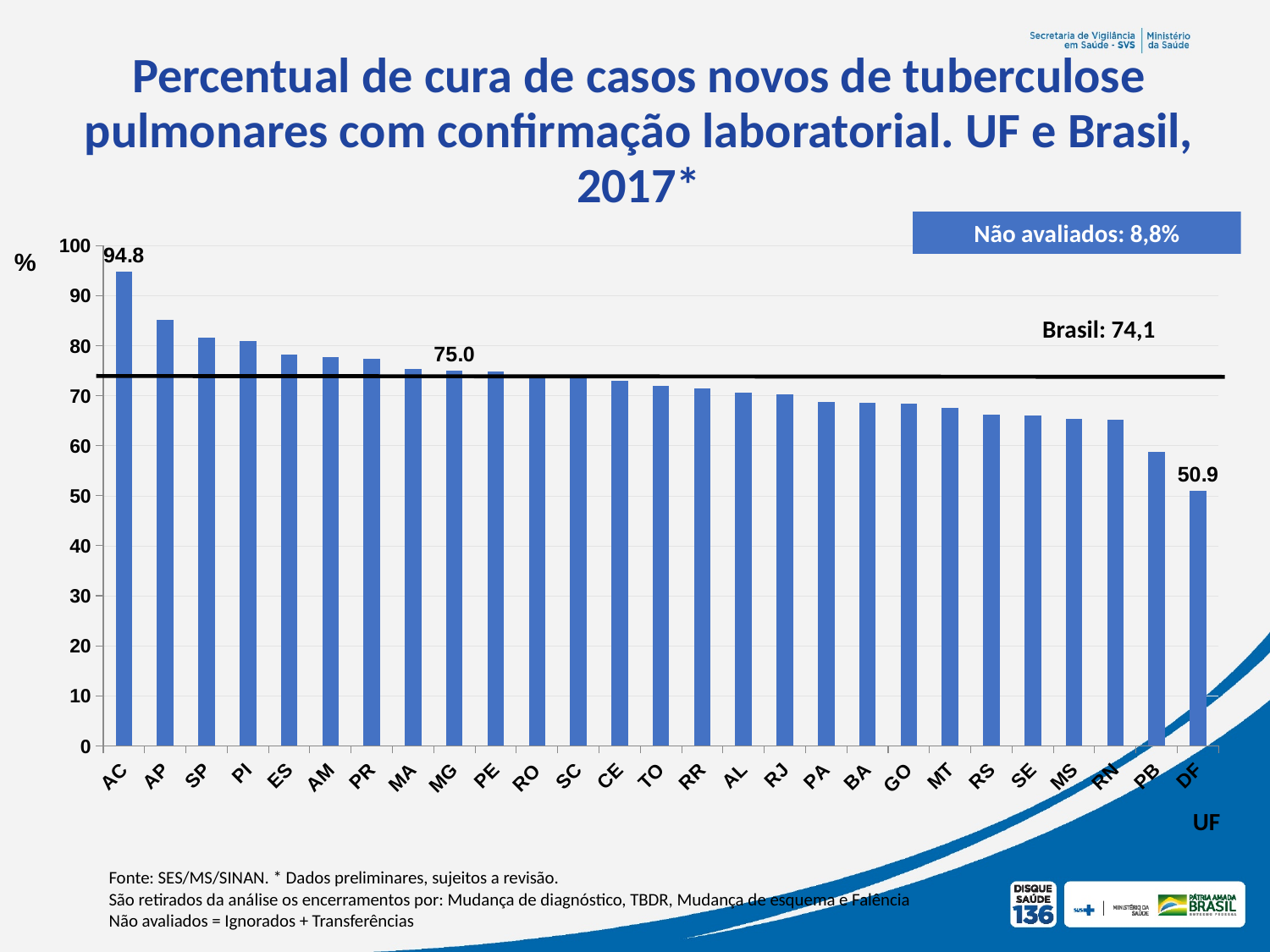
Is the value for SP greater or less than 80? greater How many UFs are shown on the x axis? 27 What value does the horizontal reference line for Brasil represent? 74,1 What is the value for MG? 75.0 What kind of chart is shown on the slide? bar chart What is the value for DF? 50.9 What is the difference between the values for AC and DF? 43.9 Which UF has the highest cure percentage? AC Which UF has the lowest cure percentage? DF Which is larger, the value for AC or the value for DF? AC Is the value for PB greater or less than 60? less What is the value for AC? 94.8